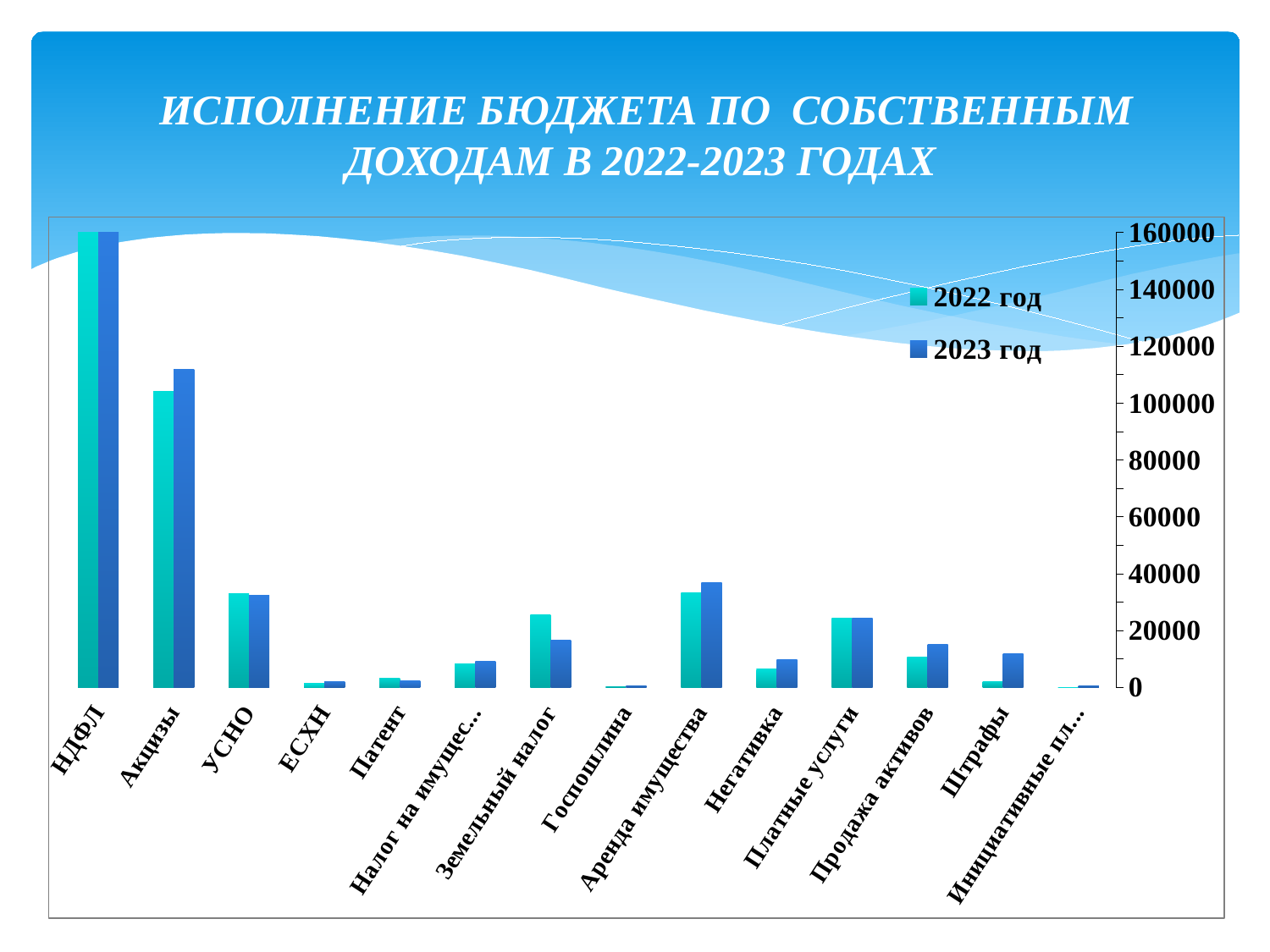
What kind of chart is shown on the slide? bar chart For Штрафы, which series has the larger value, 2022 год or 2023 год? 2023 год Is the value for Аренда имущества in 2023 год greater or less than 40000? less How many categories are shown on the x axis? 14 For Земельный налог, which series has the larger value, 2022 год or 2023 год? 2022 год How many series does the legend list? 2 Is the value for Земельный налог in 2023 год greater or less than 20000? less For Акцизы, which series has the larger value, 2022 год or 2023 год? 2023 год Which category has the highest value for 2023 год? НДФЛ Which category has the highest value for 2022 год? НДФЛ What are the two entries in the chart legend? 2022 год and 2023 год Is the value for Акцизы in 2022 год greater or less than 100000? greater